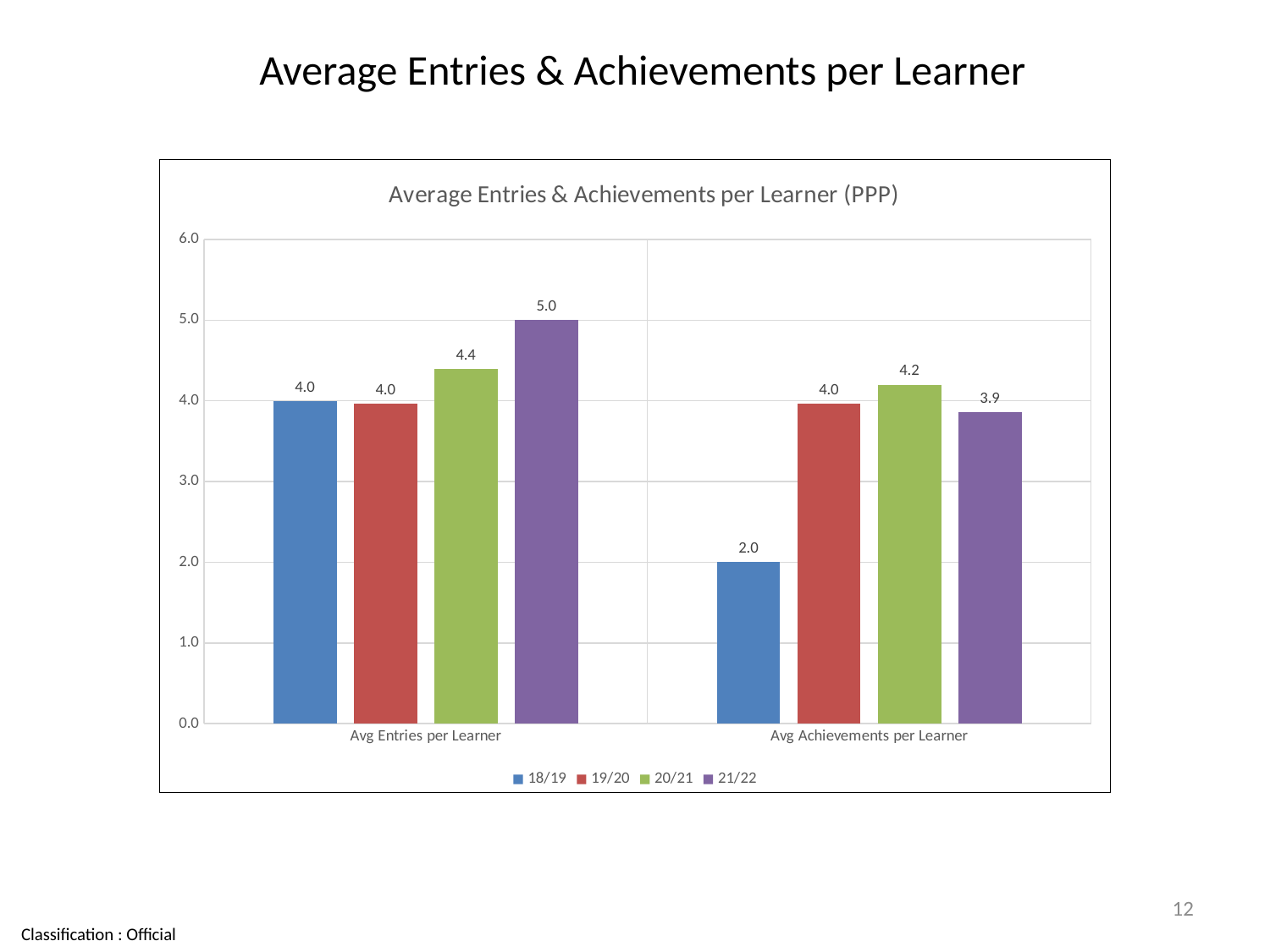
What is the value for 21/22 in the Avg Entries per Learner category? 5.0 Which is larger: the 20/21 value for Avg Entries per Learner or the 20/21 value for Avg Achievements per Learner? Avg Entries per Learner Is the 18/19 value for Avg Achievements per Learner greater or less than 3.0? less What is the value for 20/21 in the Avg Achievements per Learner category? 4.2 What kind of chart is shown on the slide? bar chart How many series does the legend list? 4 What is the value for 20/21 in the Avg Entries per Learner category? 4.4 What is the value for 18/19 in the Avg Achievements per Learner category? 2.0 What is the title of the chart? Average Entries & Achievements per Learner (PPP) Which series has the lowest value in the Avg Achievements per Learner category? 18/19 Which series has the highest value in the Avg Entries per Learner category? 21/22 What is the difference between the 21/22 value for Avg Entries per Learner and the 21/22 value for Avg Achievements per Learner? 1.1